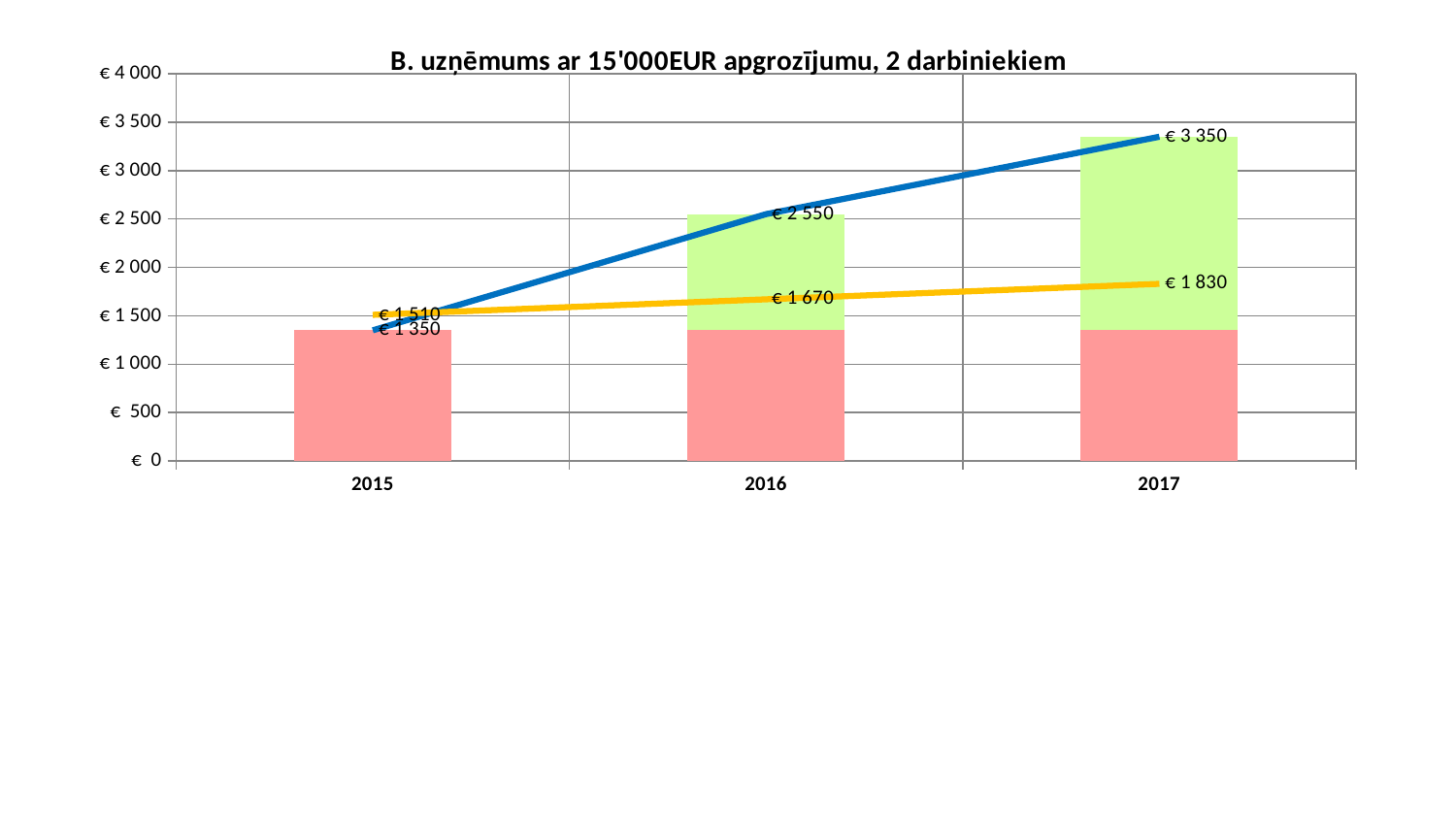
In which year does the blue line reach its highest value? 2017 Does the blue line rise or fall from 2015 to 2017? rise What is the value of the yellow line in 2017? € 1 830 How many years are shown on the x axis? 3 What is the value of the yellow line in 2015? € 1 510 What is the value of the blue line in 2017? € 3 350 In 2015, which line has the larger value, the blue line or the yellow line? the yellow line What is the value of the blue line in 2016? € 2 550 What is the difference between the blue line and the yellow line values in 2017? € 1 520 What is the value of the blue line in 2015? € 1 350 By how much does the blue line value in 2017 exceed its value in 2015? € 2 000 In which year is the yellow line at its lowest value? 2015